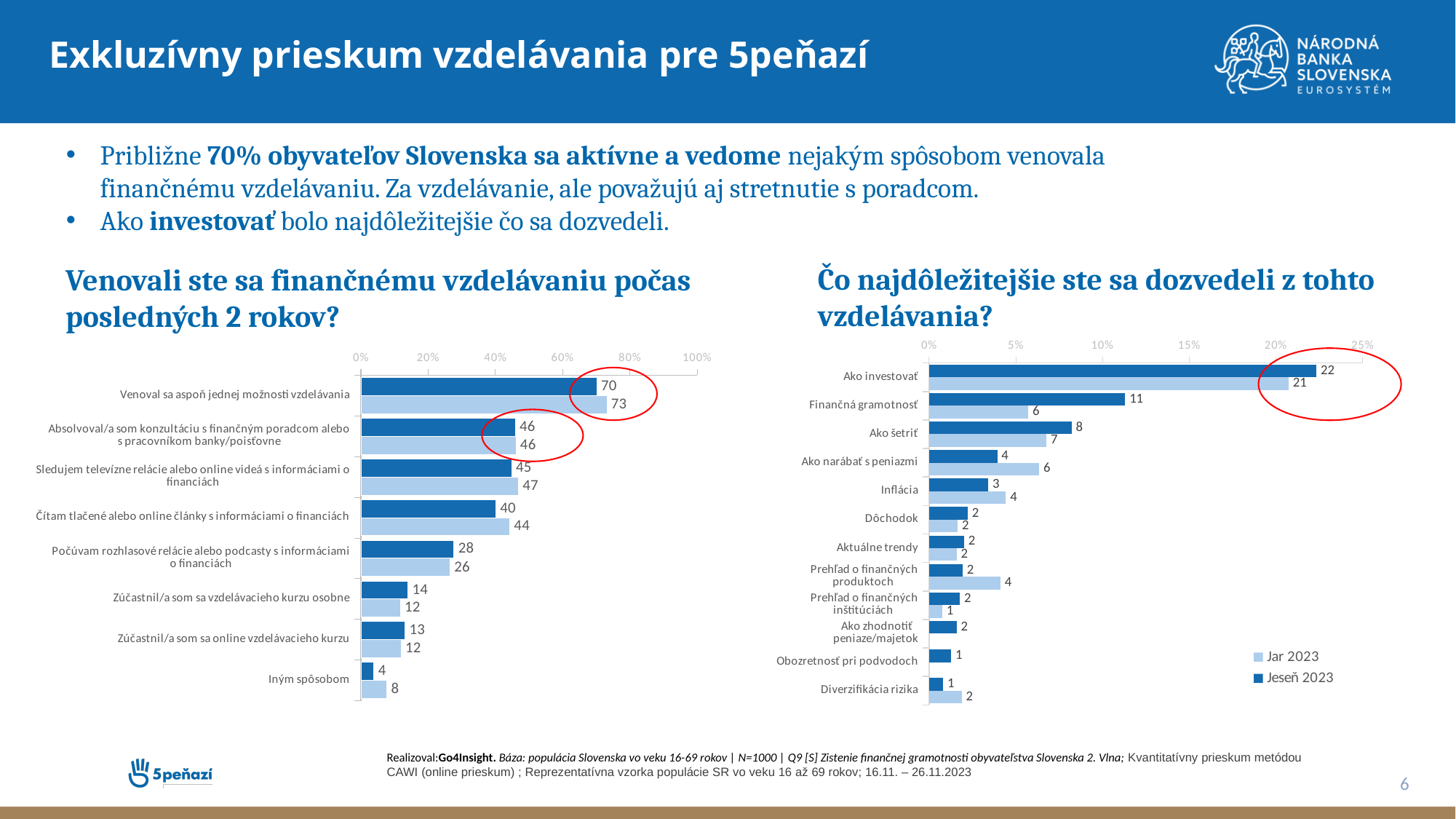
In the chart 'Čo najdôležitejšie ste sa dozvedeli z tohto vzdelávania?', what is the Jeseň 2023 value for 'Ako investovať'? 22 In the chart 'Venovali ste sa finančnému vzdelávaniu počas posledných 2 rokov?', what is the difference between the Jar 2023 and Jeseň 2023 values for 'Iným spôsobom'? 4 In the chart 'Čo najdôležitejšie ste sa dozvedeli z tohto vzdelávania?', which category has the highest Jeseň 2023 value? Ako investovať In the chart 'Venovali ste sa finančnému vzdelávaniu počas posledných 2 rokov?', is the Jeseň 2023 value for 'Počúvam rozhlasové relácie alebo podcasty s informáciami o financiách' larger or smaller than the Jar 2023 value? larger What type of chart is 'Čo najdôležitejšie ste sa dozvedeli z tohto vzdelávania?'? Bar chart In the chart 'Venovali ste sa finančnému vzdelávaniu počas posledných 2 rokov?', how many categories are shown? 8 In the chart 'Venovali ste sa finančnému vzdelávaniu počas posledných 2 rokov?', what is the Jar 2023 value for 'Venoval sa aspoň jednej možnosti vzdelávania'? 73 In the chart 'Venovali ste sa finančnému vzdelávaniu počas posledných 2 rokov?', what is the Jeseň 2023 value for 'Čítam tlačené alebo online články s informáciami o financiách'? 40 In the chart 'Čo najdôležitejšie ste sa dozvedeli z tohto vzdelávania?', what is the Jar 2023 value for 'Finančná gramotnosť'? 6 In the chart 'Čo najdôležitejšie ste sa dozvedeli z tohto vzdelávania?', what is the difference between the Jeseň 2023 and Jar 2023 values for 'Finančná gramotnosť'? 5 How many series does the legend on the right chart list? 2 In the chart 'Venovali ste sa finančnému vzdelávaniu počas posledných 2 rokov?', which category has the lowest Jeseň 2023 value? Iným spôsobom